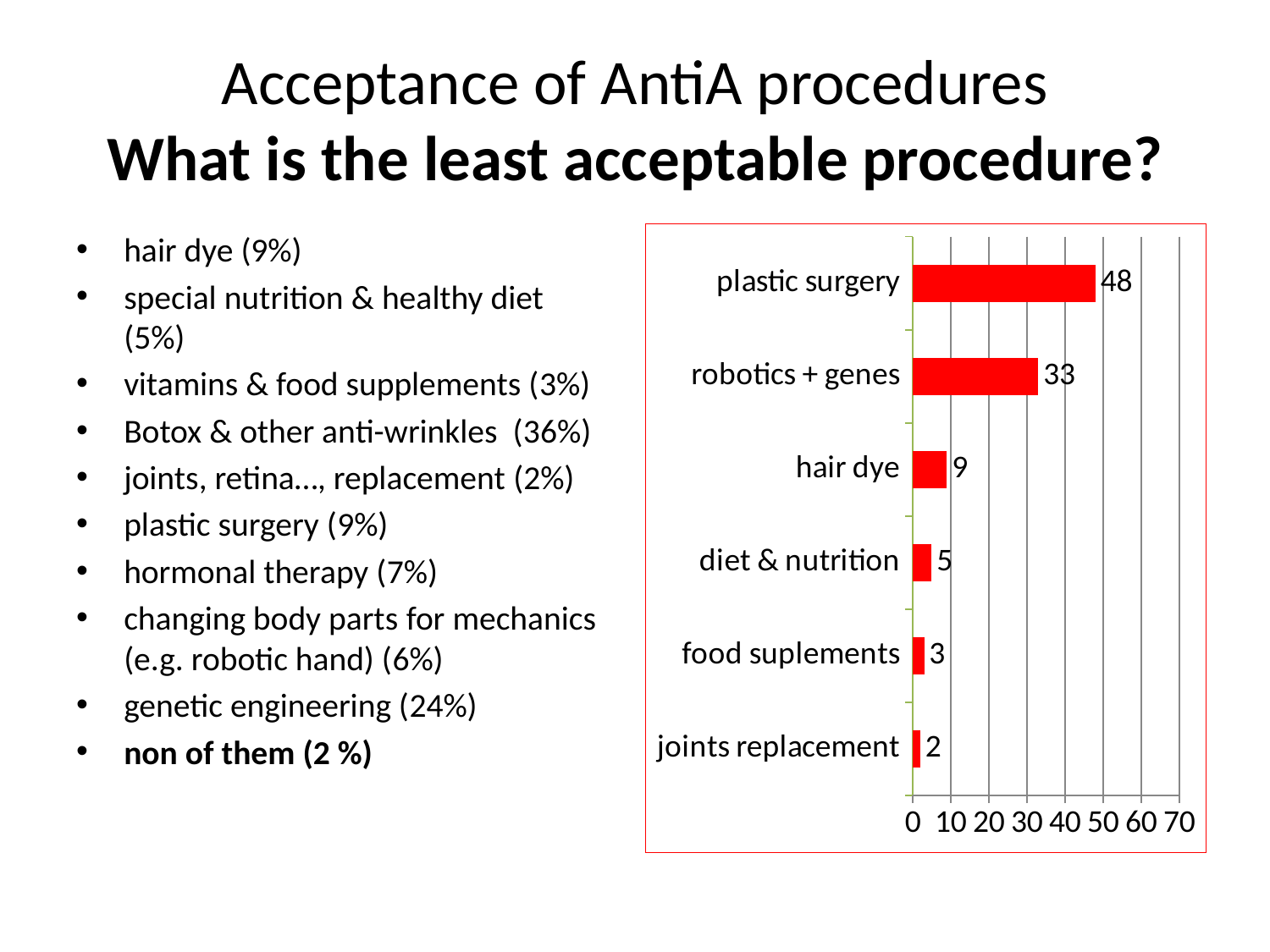
What is the value for diet & nutrition in the chart? 5 What is the value for hair dye in the chart? 9 What is the value for joints replacement in the chart? 2 What is the value for robotics + genes in the chart? 33 Which category has the lowest value in the chart? joints replacement Is the value for robotics + genes greater or less than 30? greater What kind of chart is shown on the slide? bar chart What is the difference between the values for plastic surgery and robotics + genes? 15 How many categories are shown in the chart? 6 Which category has the highest value in the chart? plastic surgery What is the value for plastic surgery in the chart? 48 Which is larger, the value for hair dye or the value for food suplements? hair dye